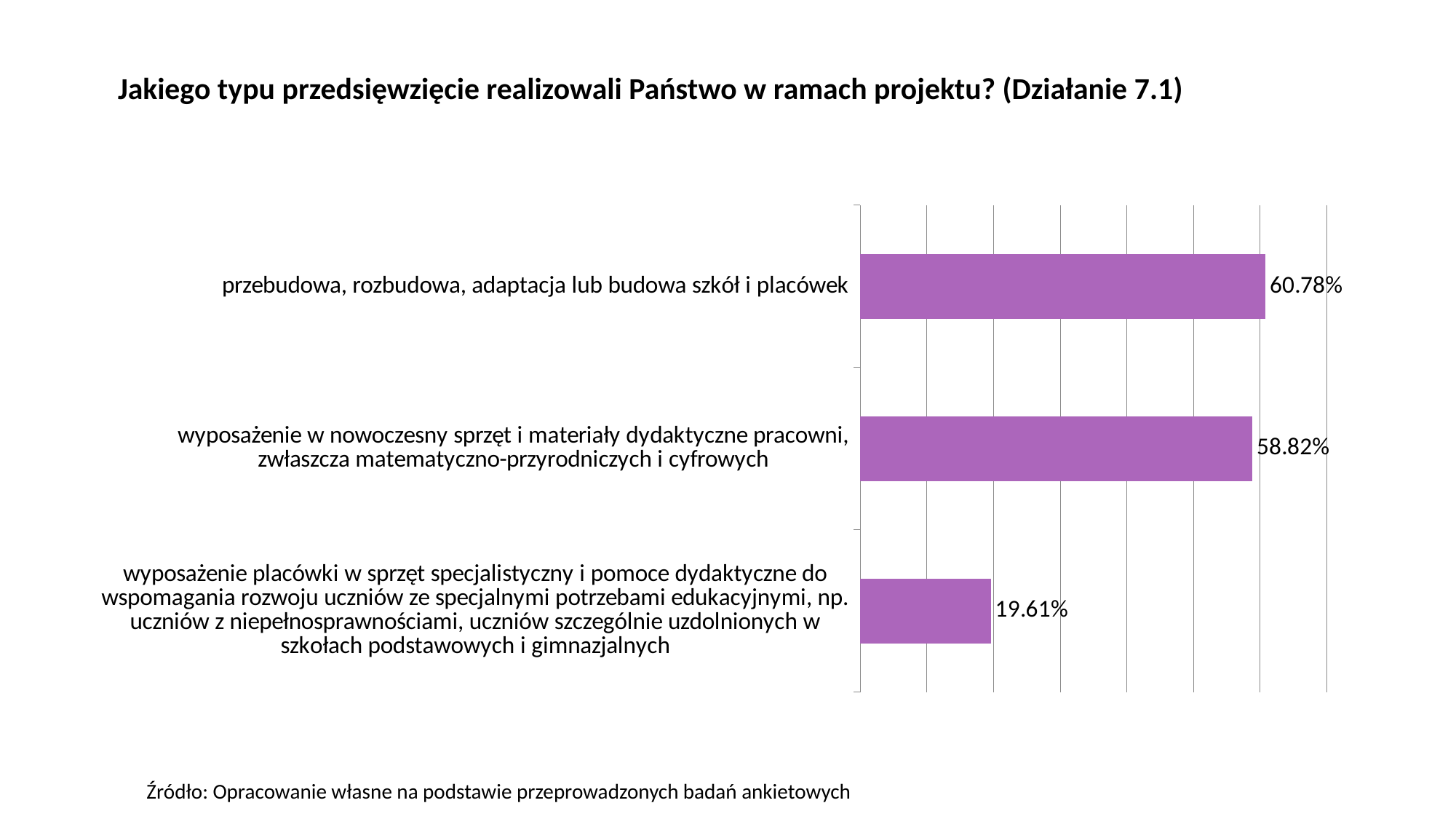
What is the value for "wyposażenie placówki w sprzęt specjalistyczny i pomoce dydaktyczne do wspomagania rozwoju uczniów ze specjalnymi potrzebami edukacyjnymi"? 19.61% What kind of chart is shown on the slide? bar chart What is the value for "wyposażenie w nowoczesny sprzęt i materiały dydaktyczne pracowni, zwłaszcza matematyczno-przyrodniczych i cyfrowych"? 58.82% Which category has the lowest value? wyposażenie placówki w sprzęt specjalistyczny i pomoce dydaktyczne do wspomagania rozwoju uczniów ze specjalnymi potrzebami edukacyjnymi How many categories are shown in the chart? 3 What is the value for "przebudowa, rozbudowa, adaptacja lub budowa szkół i placówek"? 60.78% Which category has the highest value? przebudowa, rozbudowa, adaptacja lub budowa szkół i placówek What is the difference between the value for "przebudowa, rozbudowa, adaptacja lub budowa szkół i placówek" and the value for "wyposażenie w nowoczesny sprzęt i materiały dydaktyczne pracowni"? 1.96% What is the title of the chart? Jakiego typu przedsięwzięcie realizowali Państwo w ramach projektu? (Działanie 7.1) What is the difference between the value for "wyposażenie w nowoczesny sprzęt i materiały dydaktyczne pracowni" and the value for "wyposażenie placówki w sprzęt specjalistyczny i pomoce dydaktyczne"? 39.21% What is the difference between the highest and lowest values in the chart? 41.17% Which is larger: the value for "przebudowa, rozbudowa, adaptacja lub budowa szkół i placówek" or the value for "wyposażenie w nowoczesny sprzęt i materiały dydaktyczne pracowni"? przebudowa, rozbudowa, adaptacja lub budowa szkół i placówek